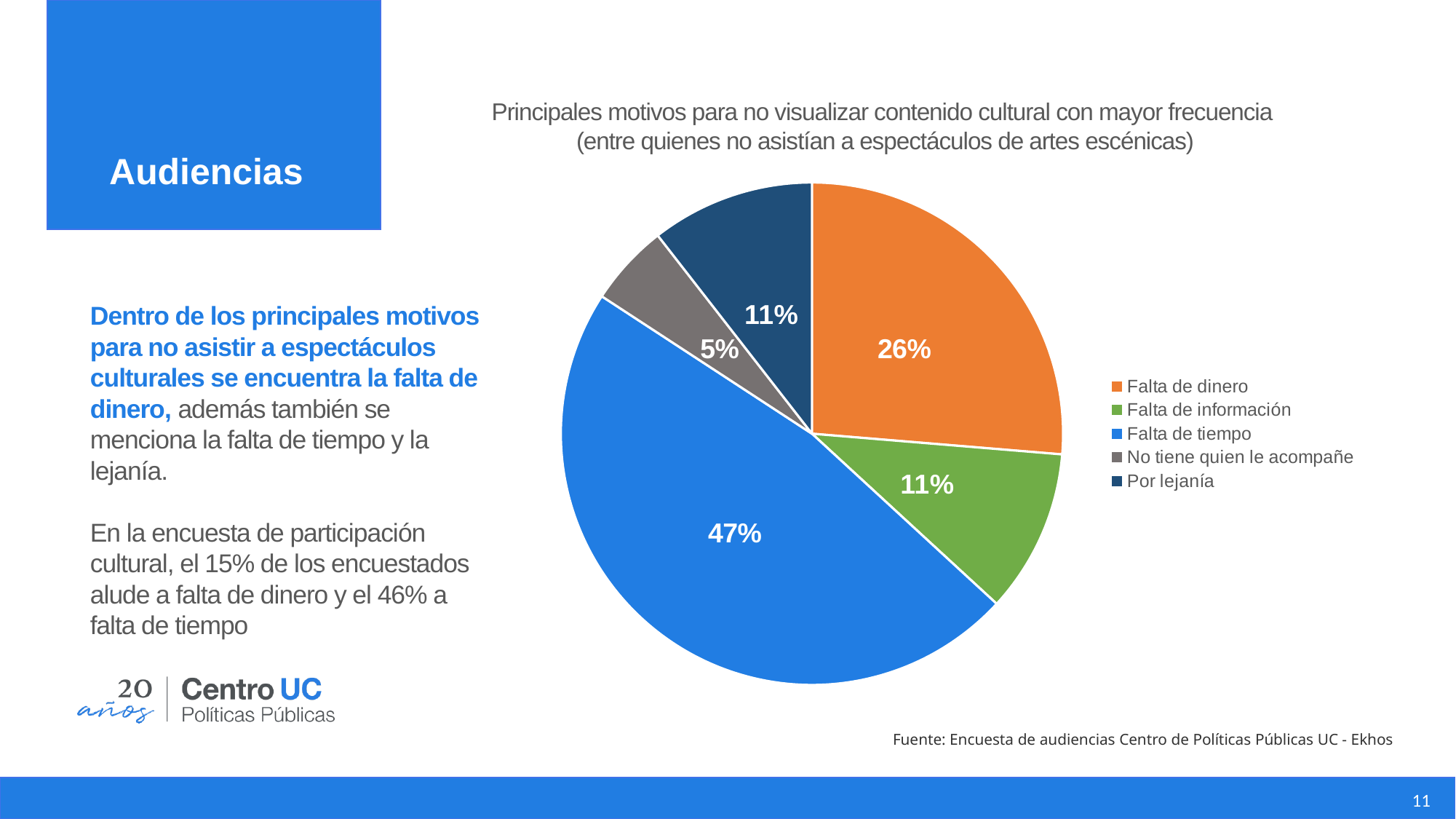
What colour is the slice for "Falta de información"? green What is the title of the chart? Principales motivos para no visualizar contenido cultural con mayor frecuencia (entre quienes no asistían a espectáculos de artes escénicas) What is the difference between the values for "Falta de tiempo" and "Falta de dinero"? 21% What type of chart is shown on the slide? pie chart What is the value shown for "Por lejanía"? 11% What is the value shown for "No tiene quien le acompañe"? 5% Which category has the smallest slice of the pie? No tiene quien le acompañe What share of the pie does "Falta de tiempo" represent? 47% Which is larger, the value for "Falta de dinero" or the value for "Falta de información"? Falta de dinero What is the value shown for "Falta de dinero"? 26% Which category has the largest slice of the pie? Falta de tiempo How many categories does the pie chart have? 5